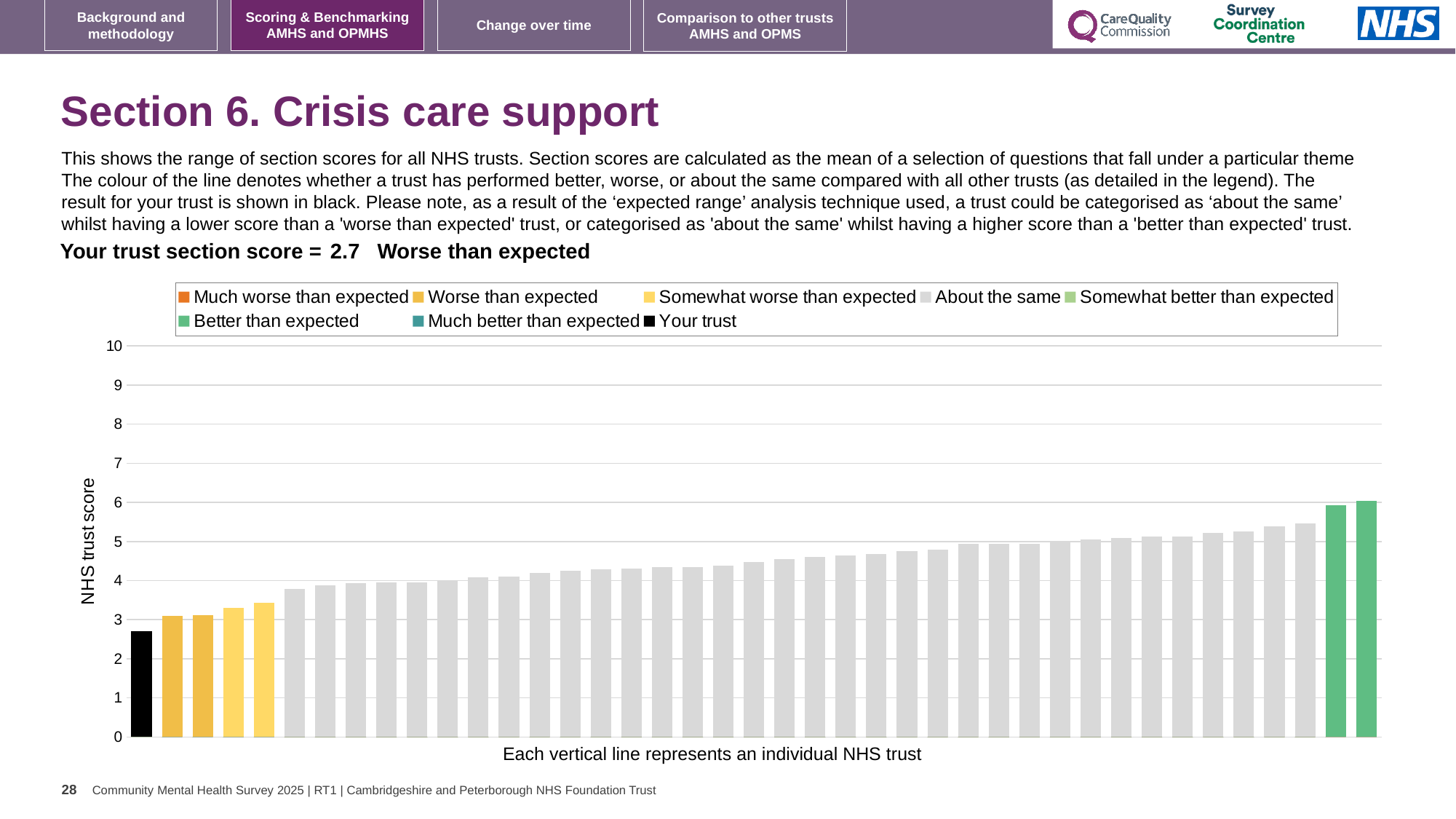
What is the label on the vertical axis of the chart? NHS trust score Is the value of the rightmost bar greater or less than 7? less Do the bar values rise or fall from left to right along the x axis? rise What is the section score for your trust (the black bar)? 2.7 Which bar is the lowest in the chart? Your trust (the black bar) Is the value of the rightmost bar greater or less than 5? greater How many entries does the chart legend list? 8 Which is larger, the black 'Your trust' bar or the rightmost green bar? The rightmost green bar What kind of chart is shown on the slide? Bar chart Is the value for your trust (the black bar) greater or less than 3? less How many bars are coloured as 'Better than expected' (green)? 2 Which category is your trust placed in for this section? Worse than expected